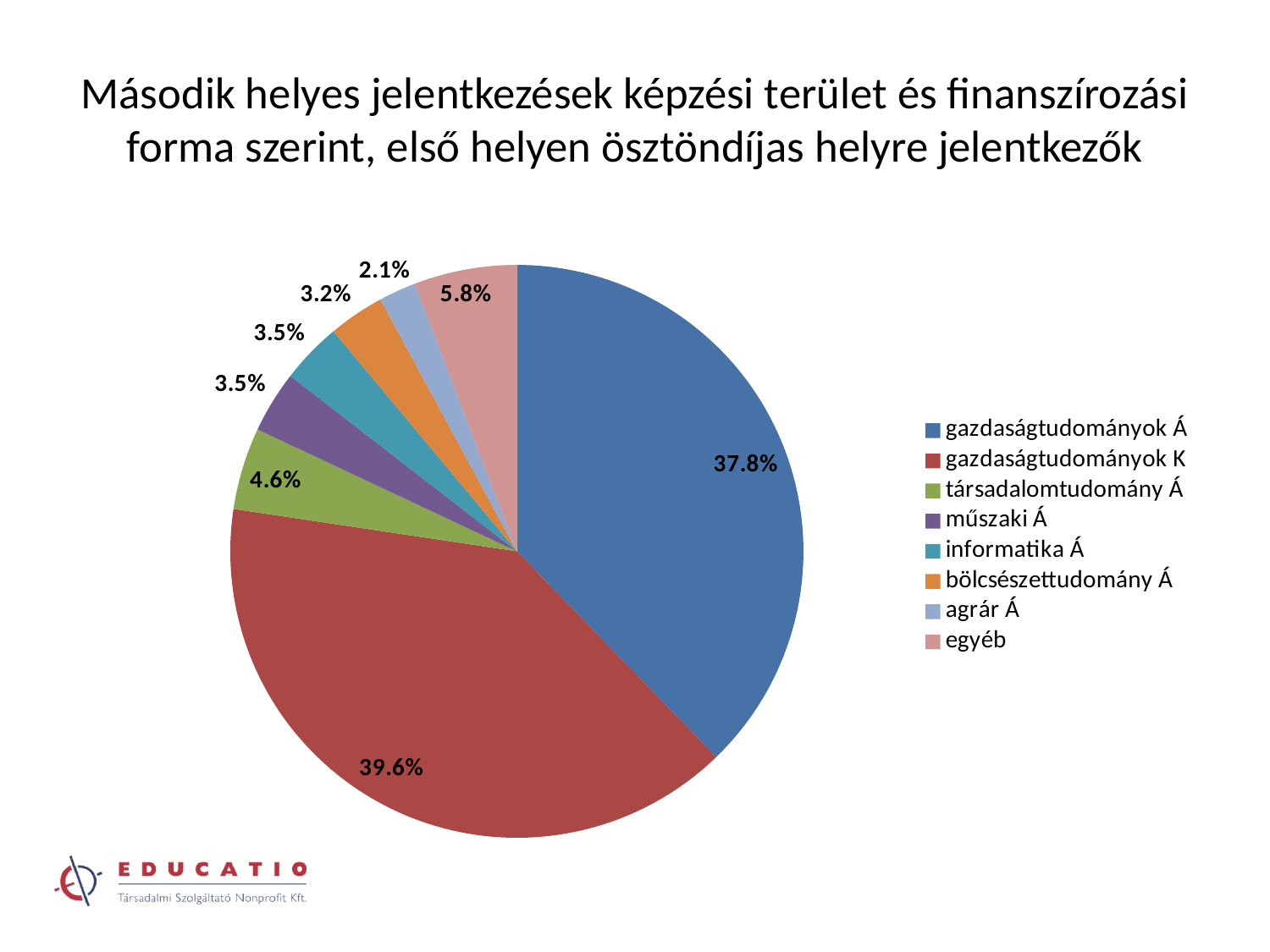
Which category has the smallest slice of the pie? agrár Á What is the value for társadalomtudomány Á? 4.6% What kind of chart is shown on the slide? pie chart What is the difference between the shares of gazdaságtudományok K and gazdaságtudományok Á? 1.8% How many categories does the legend list? 8 Which category has the largest slice of the pie? gazdaságtudományok K What share of the pie does gazdaságtudományok K have? 39.6% What share of the pie does gazdaságtudományok Á have? 37.8% What is the value for agrár Á? 2.1% Which is larger, the share of egyéb or the share of társadalomtudomány Á? egyéb What is the value for bölcsészettudomány Á? 3.2% What is the value for egyéb? 5.8%